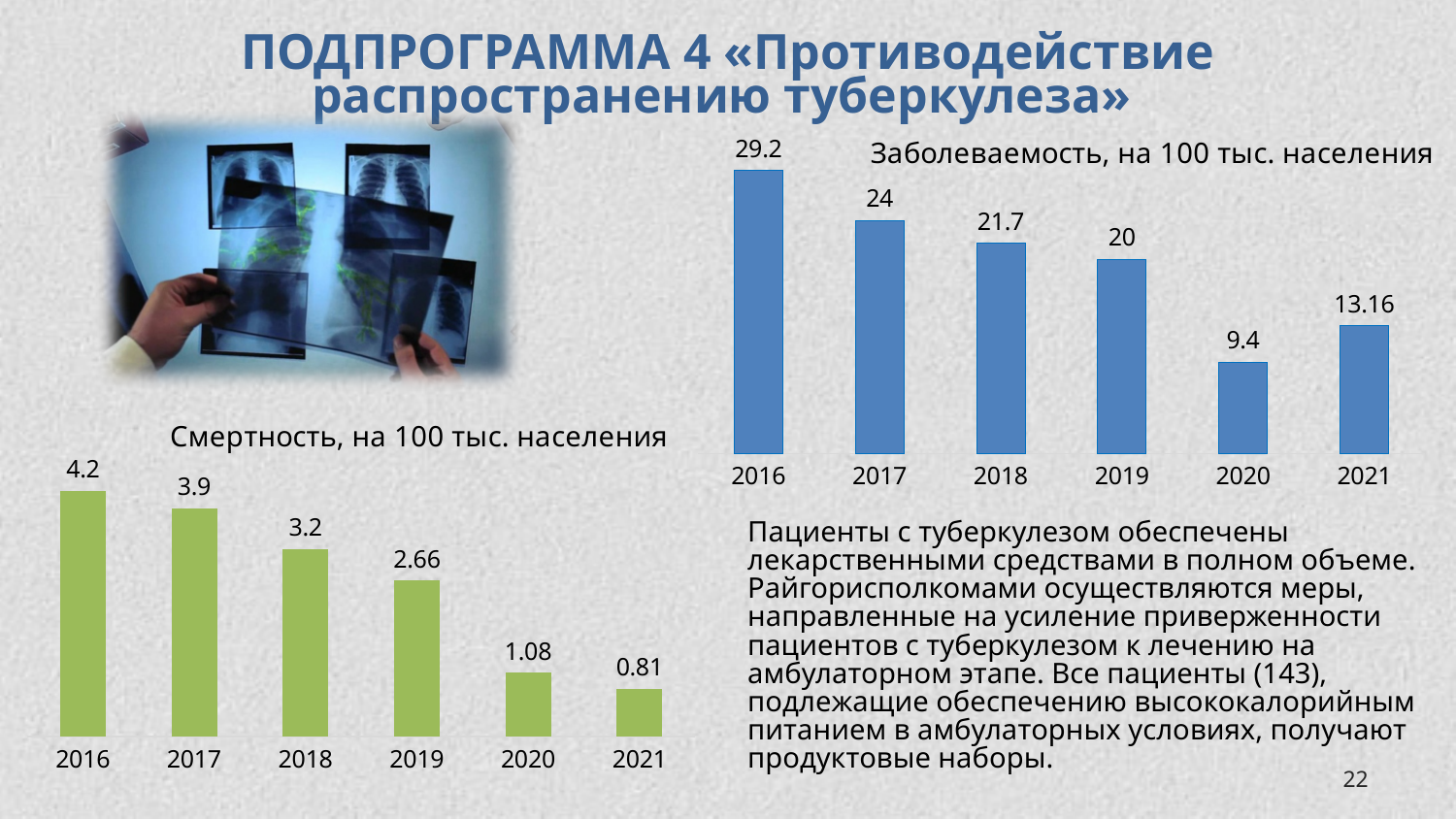
What kind of chart is the chart titled «Смертность, на 100 тыс. населения»? bar chart In the chart titled «Смертность, на 100 тыс. населения», what is the value for 2019? 2.66 In the chart titled «Смертность, на 100 тыс. населения», what is the difference between the values for 2017 and 2020? 2.82 In the chart titled «Заболеваемость, на 100 тыс. населения», which is larger, the value for 2020 or the value for 2021? 2021 In the chart titled «Заболеваемость, на 100 тыс. населения», what is the difference between the values for 2016 and 2021? 16.04 In the chart titled «Заболеваемость, на 100 тыс. населения», which year has the highest value? 2016 What colour are the bars in the chart titled «Заболеваемость, на 100 тыс. населения»? blue In the chart titled «Смертность, на 100 тыс. населения», do the values rise or fall from 2016 to 2021? fall In the chart titled «Заболеваемость, на 100 тыс. населения», what is the value for 2018? 21.7 In the chart titled «Смертность, на 100 тыс. населения», which is larger, the value for 2018 or the value for 2019? 2018 How many years are shown in the chart titled «Заболеваемость, на 100 тыс. населения»? 6 In the chart titled «Смертность, на 100 тыс. населения», which year has the lowest value? 2021